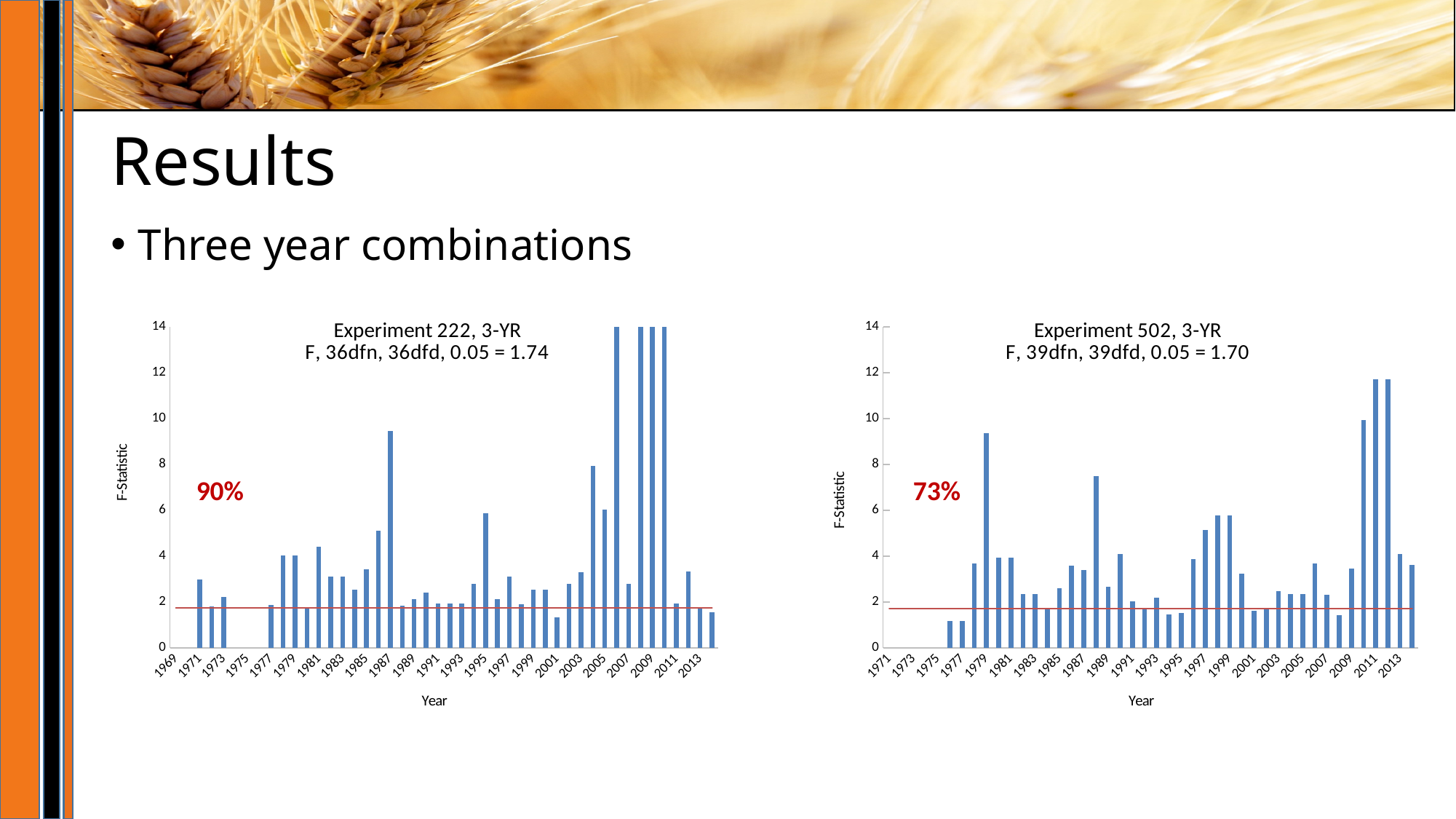
In the Experiment 222, 3-YR chart, is the F-statistic for 1987 greater or less than 8? greater In the Experiment 222, 3-YR chart, is the F-statistic for 1995 greater or less than 4? greater In the Experiment 502, 3-YR chart, is the F-statistic for 1977 greater or less than 2? less What is the y-axis label of the Experiment 502, 3-YR chart? F-Statistic In the Experiment 222, 3-YR chart, which year has the higher F-statistic, 1987 or 1995? 1987 What type of chart is the Experiment 222, 3-YR chart on the left? bar chart In the Experiment 502, 3-YR chart, which year has the higher F-statistic, 1979 or 1997? 1979 What percentage is printed in red on the Experiment 222, 3-YR chart? 90%